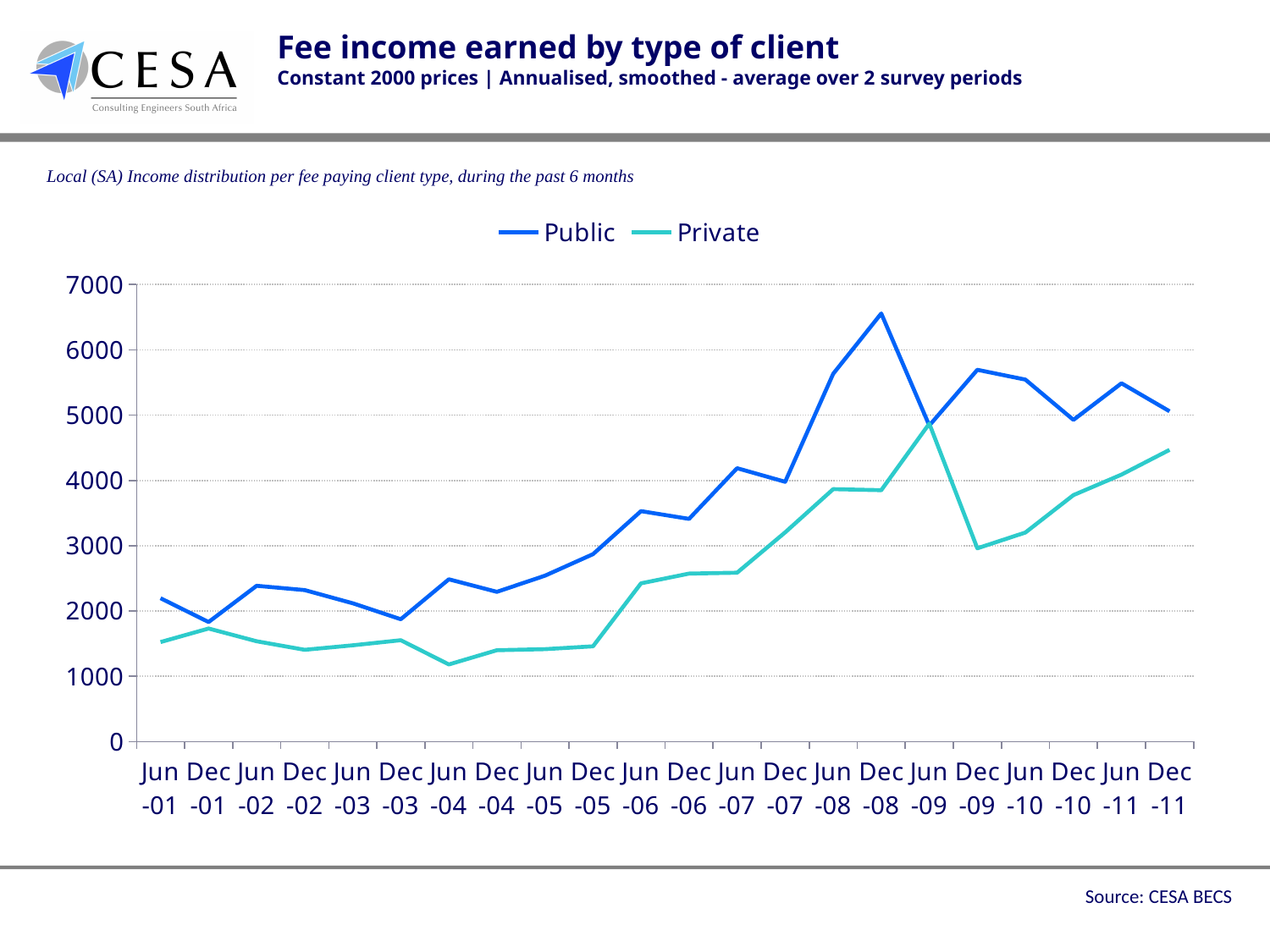
In which period does the Private series reach its highest value? Jun-09 Is the value for Private in Dec-11 greater or less than 5000? less In Dec-08, which series has the larger value, Public or Private? Public How many survey periods are plotted along the x axis? 22 Does the Private series rise or fall between Jun-09 and Dec-09? Fall Is the value for Public in Dec-08 greater or less than 6000? greater What kind of chart is shown on the slide? Line chart How many series does the legend list? 2 In which period does the Public series reach its highest value? Dec-08 Is the value for Private in Jun-04 greater or less than 1500? less In which period does the Private series reach its lowest value? Jun-04 Which two series are shown in the legend? Public and Private